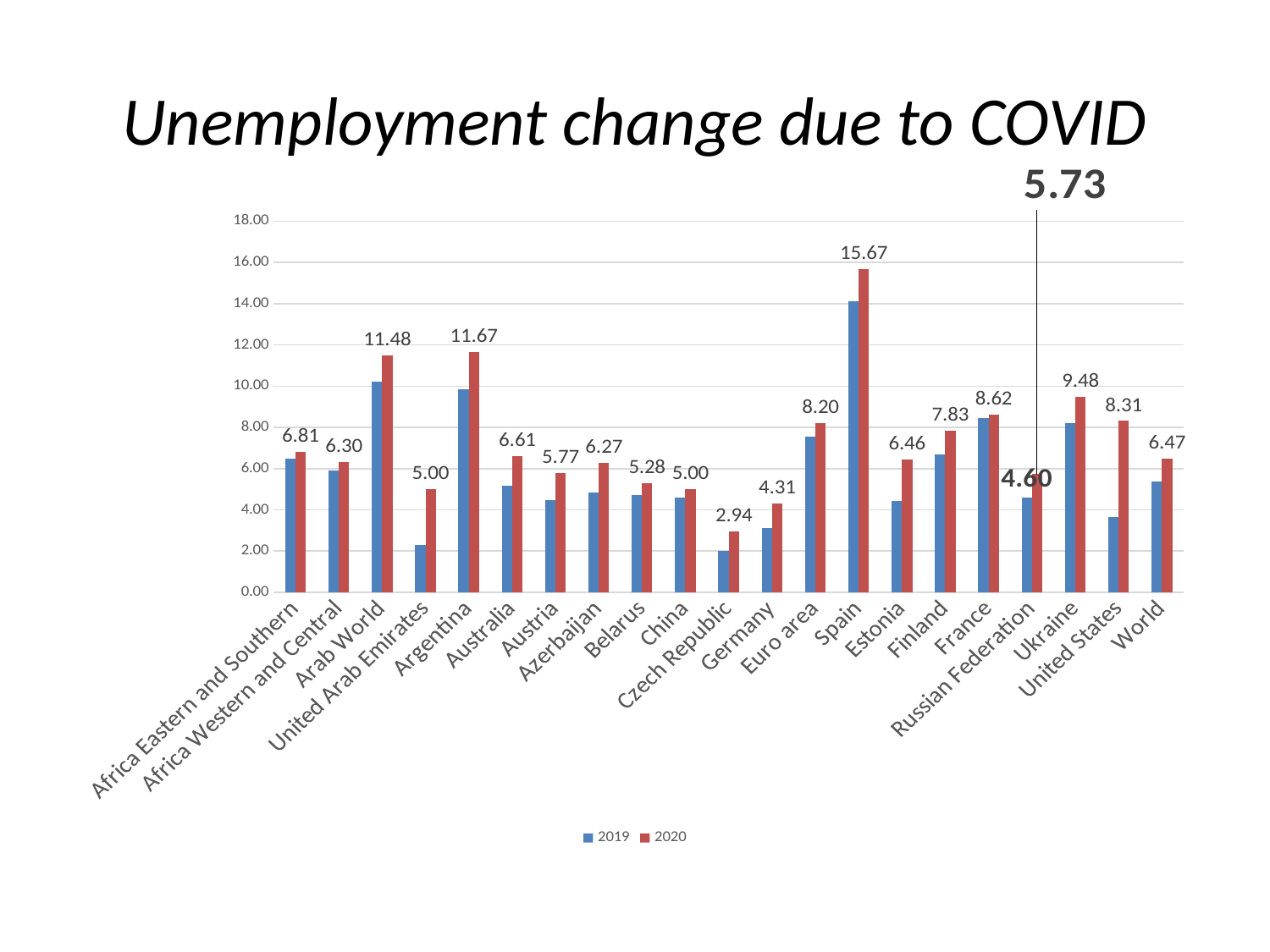
What is the 2020 unemployment value for Spain? 15.67 What is the difference between the 2020 values for Spain and Ukraine? 6.19 What is the 2020 value shown for Ukraine? 9.48 Which category has the lowest 2020 value? Czech Republic How many categories are shown on the x axis? 21 How many series does the legend list? 2 Which category has the highest 2020 value? Spain What is the 2019 value shown for the Russian Federation? 4.60 Which has the larger 2020 value, Arab World or Argentina? Argentina What type of chart is shown on the slide? Bar chart By how much did the Russian Federation's value increase from 2019 to 2020? 1.13 Is the 2019 value for United Arab Emirates greater or less than 4.00? less